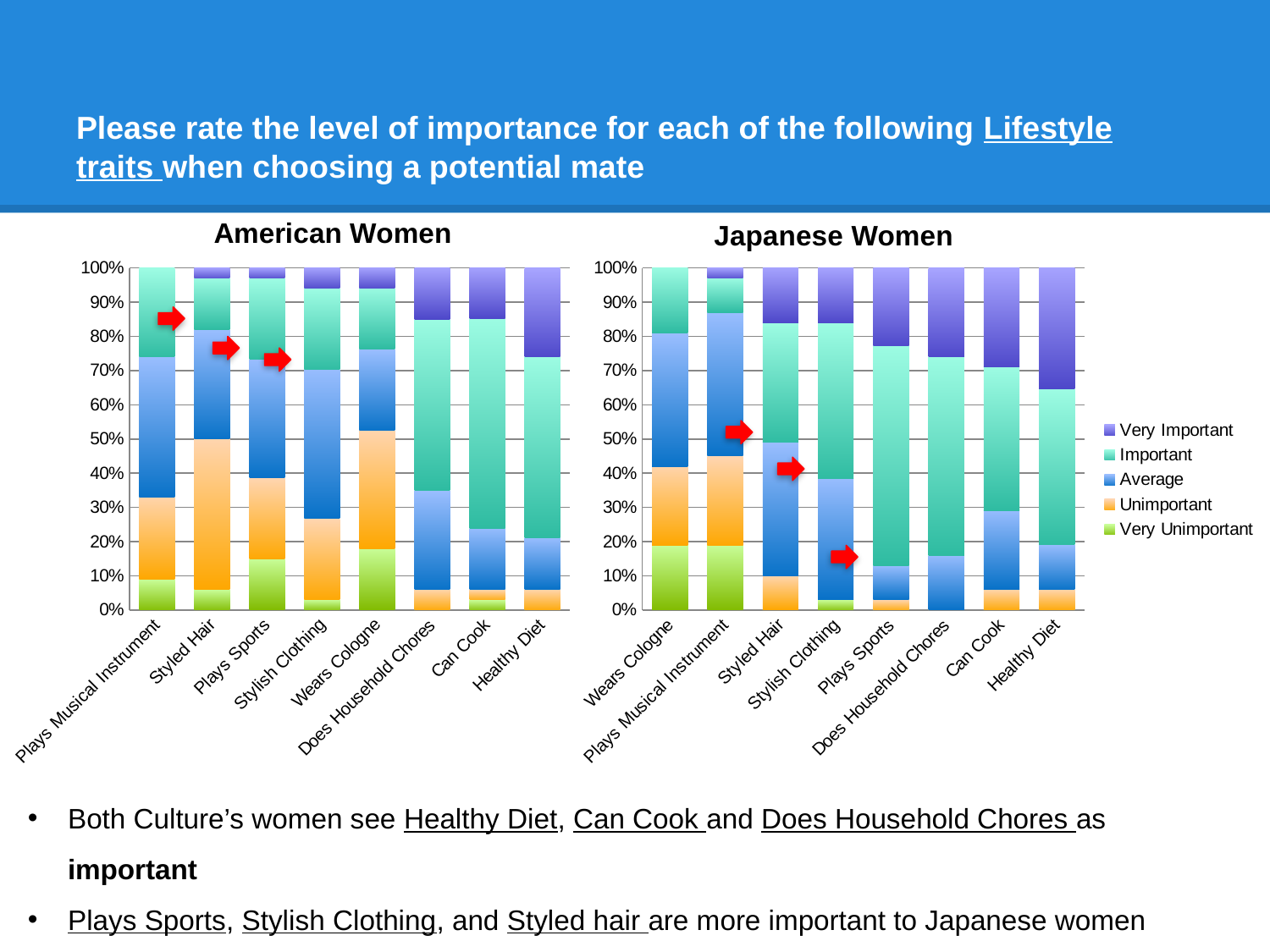
What kind of chart is the American Women chart? stacked bar chart In the Japanese Women chart, is the top of the Average segment for Wears Cologne greater or less than 70%? greater What is the title of the chart on the right? Japanese Women In the American Women chart, which category has the largest Unimportant segment? Styled Hair In the Japanese Women chart, is the Very Important segment for Styled Hair larger or smaller than the Very Important segment for Healthy Diet? smaller Is the Very Important segment for Healthy Diet larger in the American Women chart or the Japanese Women chart? Japanese Women How many series does the legend list? 5 How many categories are shown on the x axis of the Japanese Women chart? 8 In the Japanese Women chart, which category has no Very Important segment? Wears Cologne In the American Women chart, is the top of the Unimportant segment for Styled Hair greater or less than 40%? greater In the American Women chart, which category has the largest Very Important segment? Healthy Diet Which series is listed first in the legend? Very Important